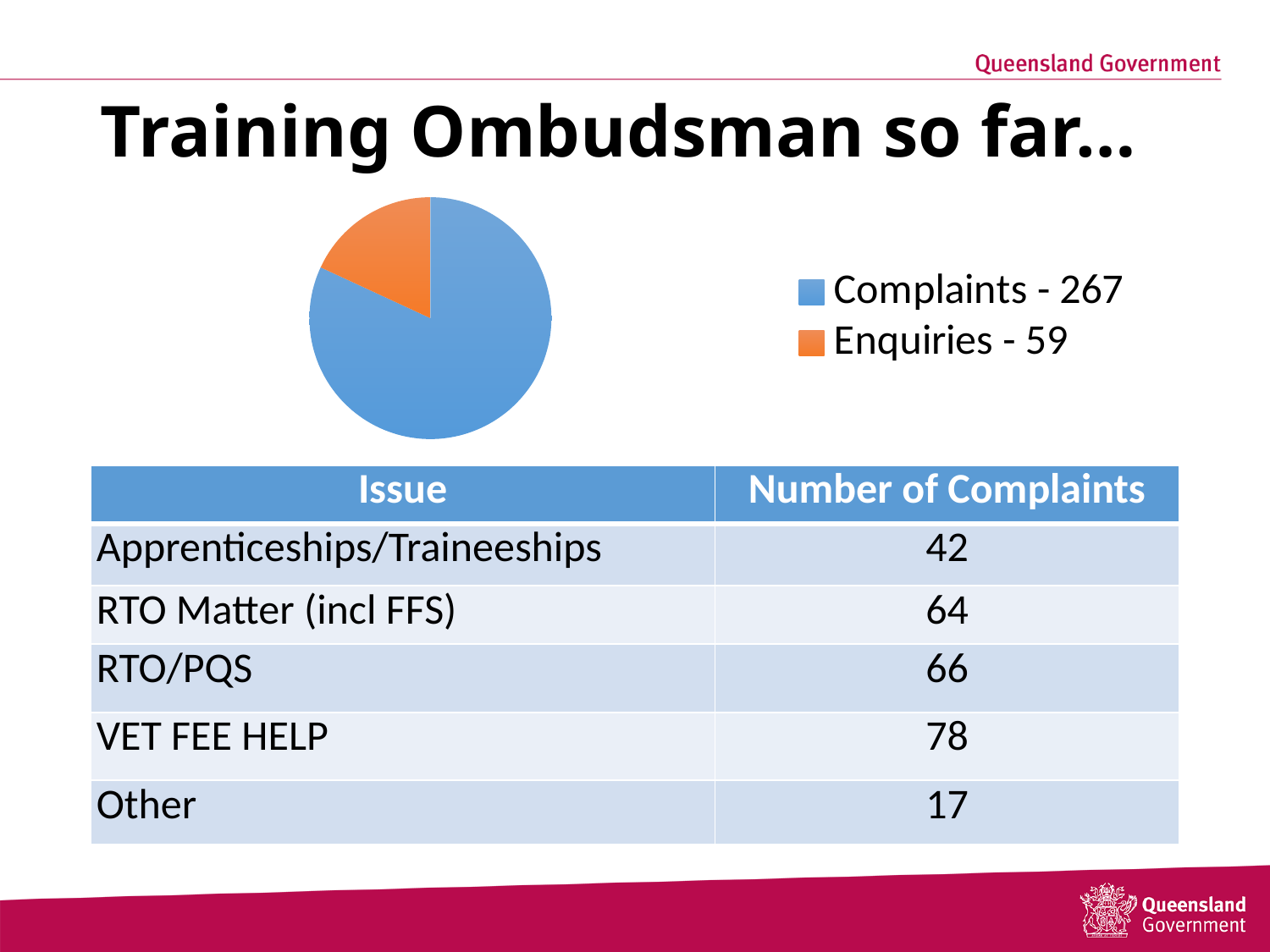
How many entries does the pie chart's legend list? 2 What is the number of Complaints shown in the pie chart legend? 267 Which category in the pie chart is the smallest? Enquiries What colour is the Enquiries slice in the pie chart? orange What is the total of Complaints and Enquiries shown in the pie chart? 326 Which category in the pie chart is the largest? Complaints How many slices does the pie chart have? 2 Which is larger in the pie chart, Complaints or Enquiries? Complaints What is the difference between the number of Complaints and the number of Enquiries in the pie chart? 208 What is the number of Enquiries shown in the pie chart legend? 59 What colour is the Complaints slice in the pie chart? blue What type of chart is shown on the slide? pie chart